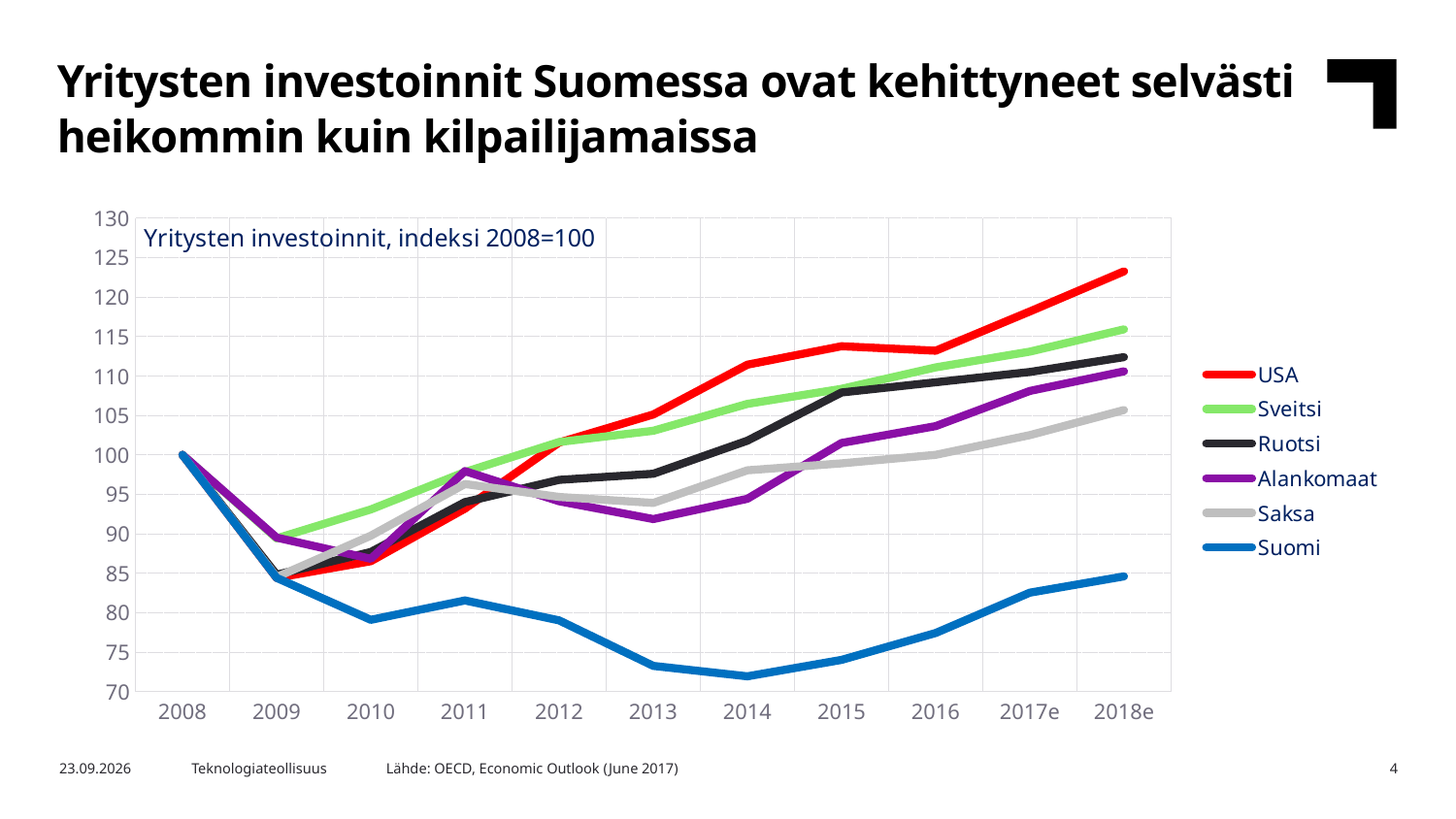
Is the value for Ruotsi in 2015 greater or less than 105? greater Which series has the lowest value in 2018e? Suomi What kind of chart is shown on the slide? line chart Does the value for Suomi rise or fall from 2008 to 2014? fall How many points are there along the x axis? 11 What is the value for Suomi in 2008? 100 What is the title shown inside the chart area? Yritysten investoinnit, indeksi 2008=100 Which series has the highest value in 2018e? USA How many series does the legend list? 6 Is the value for USA in 2018e greater or less than 120? greater Is the value for Suomi in 2014 greater or less than 75? less Which is larger in 2016, the value for Sveitsi or the value for Saksa? Sveitsi